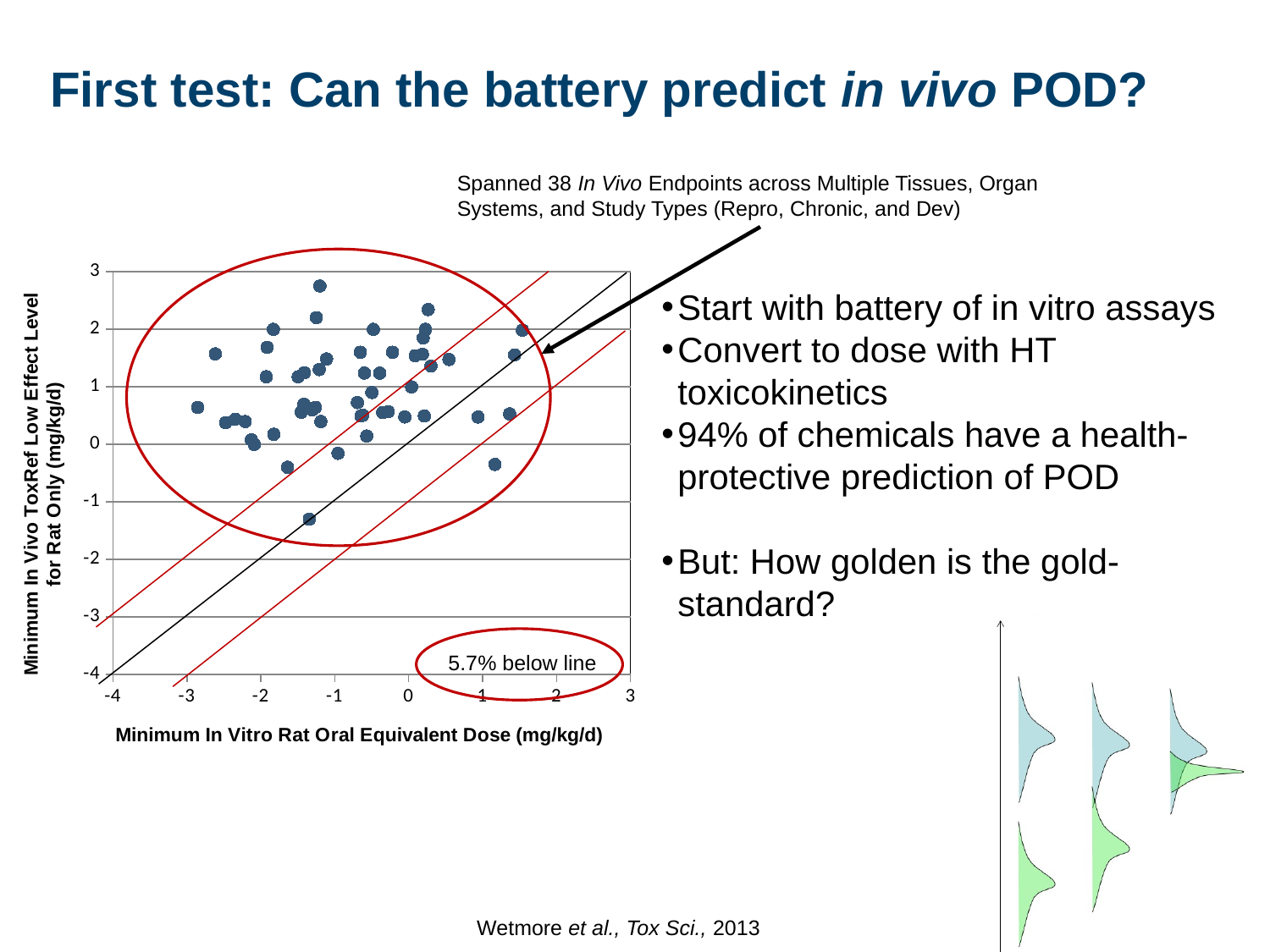
Is the y value of the lowest plotted point greater or less than -1? less Is the y value of the highest plotted point greater or less than 2? greater Are most of the plotted points above or below the black diagonal line? above What text is written inside the small red circle at the bottom right of the scatter chart? 5.7% below line What is the title of the x axis of the scatter chart? Minimum In Vitro Rat Oral Equivalent Dose (mg/kg/d) What kind of chart is shown on the slide? scatter chart Is the x value of the rightmost plotted point greater or less than 2? less